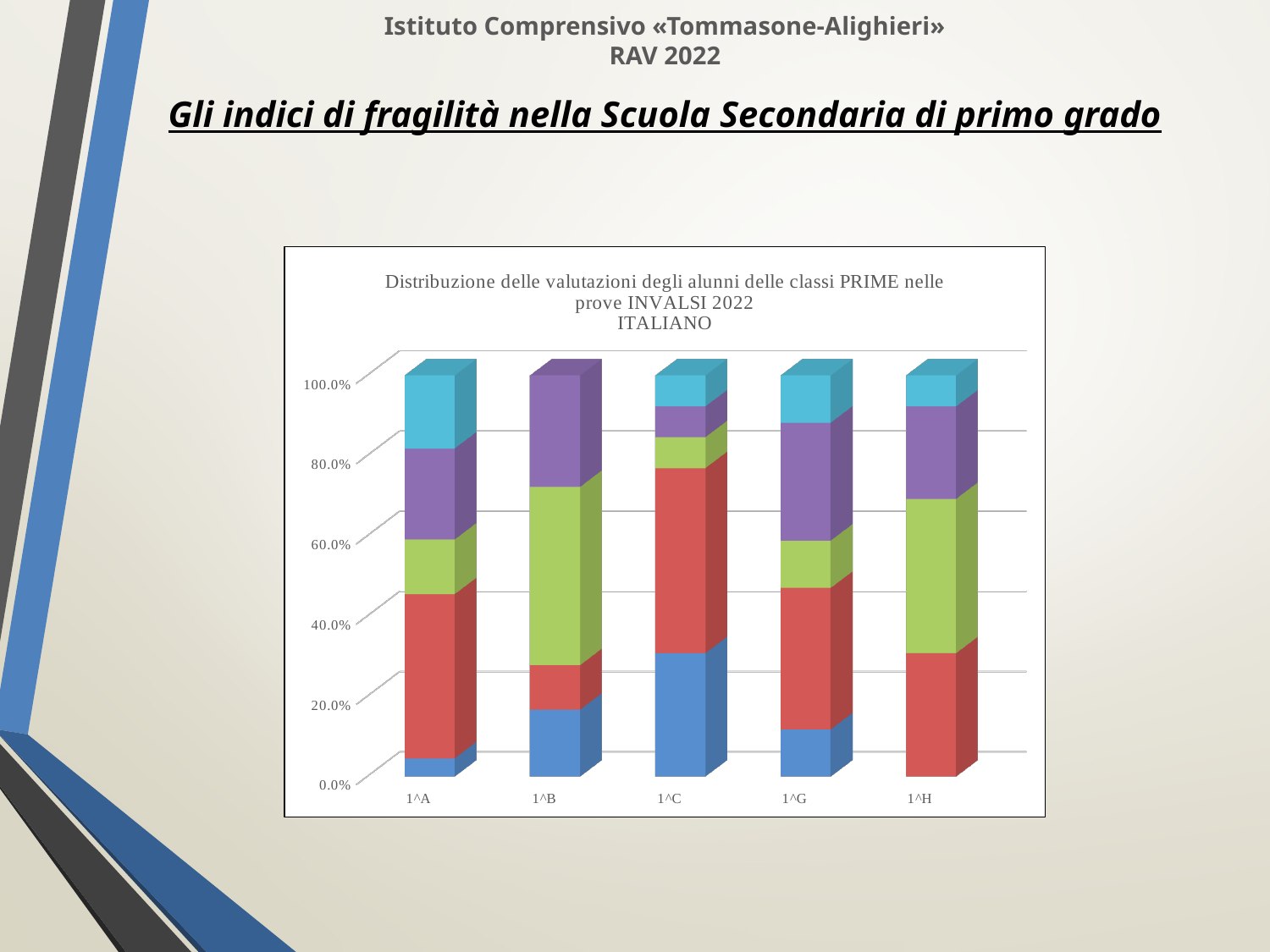
Which class labels appear along the x axis of the chart? 1^A, 1^B, 1^C, 1^G, 1^H What kind of chart is shown on the slide? stacked bar chart Is the top of the red segment of the 1^B bar greater or less than 40.0%? less Is the top of the bottom (blue) segment of the 1^C bar greater or less than 20.0%? greater What is the title of the chart? Distribuzione delle valutazioni degli alunni delle classi PRIME nelle prove INVALSI 2022 ITALIANO What is the total height of the stacked bar for 1^A? 100.0% How many classes are shown along the x axis of the chart? 5 Is the top of the bottom (blue) segment of the 1^A bar greater or less than 20.0%? less What is the total height of the stacked bar for 1^H? 100.0% Which class has the tallest bottom (blue) segment? 1^C